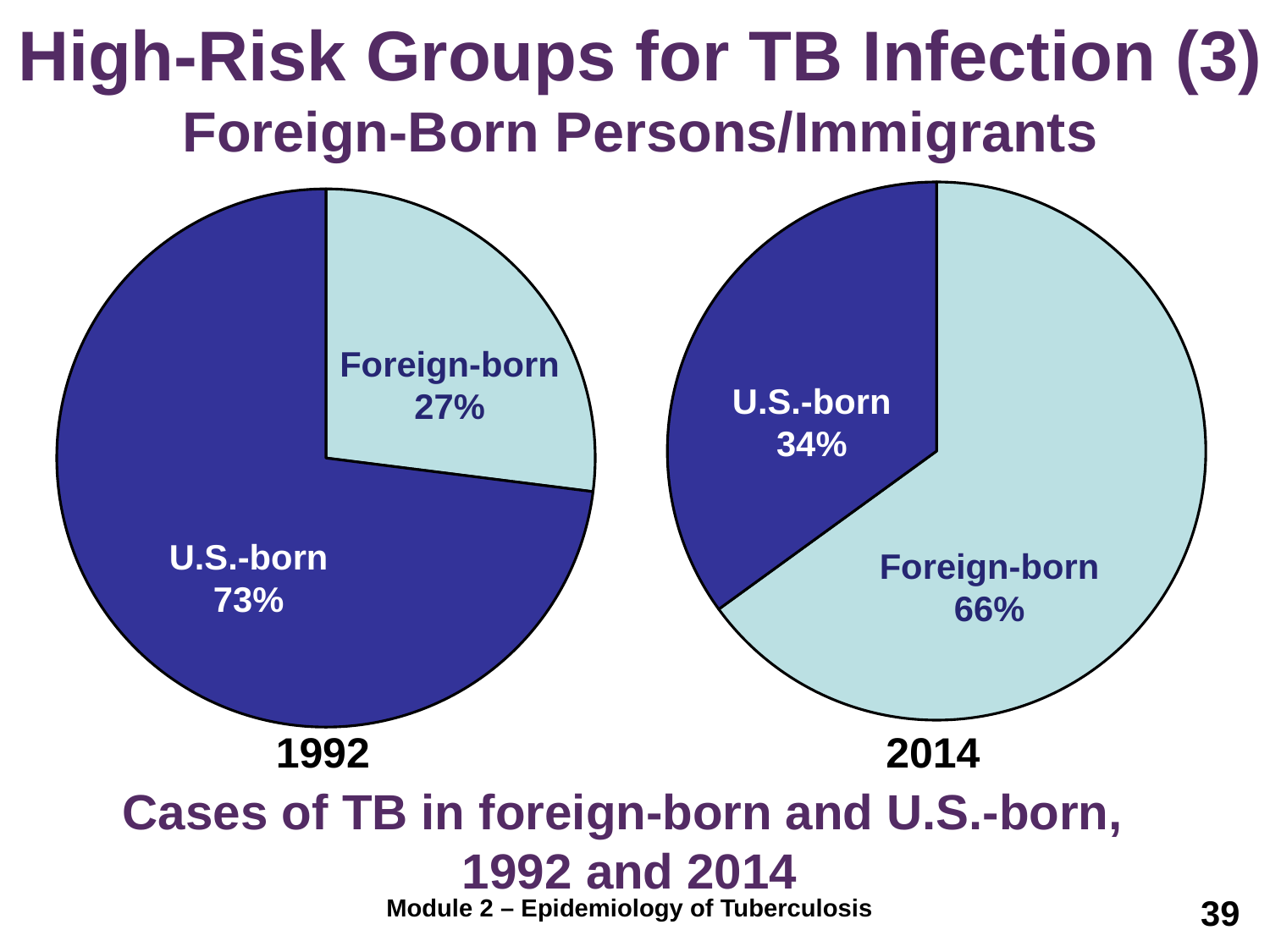
In the 1992 pie chart, what share of TB cases were in U.S.-born persons? 73% In the 1992 pie chart, what is the difference in percentage points between the U.S.-born and foreign-born shares? 46 What is the difference in percentage points between the foreign-born share in 2014 and the foreign-born share in 1992? 39 In the 2014 pie chart, what share of TB cases were in foreign-born persons? 66% What type of chart is used on this slide? Pie chart In the 1992 pie chart, which group has the larger slice? U.S.-born How many slices does each pie chart on the slide have? 2 In the 2014 pie chart, what share of TB cases were in U.S.-born persons? 34% Is the foreign-born share of TB cases larger in the 1992 chart or the 2014 chart? 2014 Which colour represents the foreign-born slice in both pie charts? Light blue In the 1992 pie chart, what share of TB cases were in foreign-born persons? 27% In the 2014 pie chart, which group has the smaller slice? U.S.-born